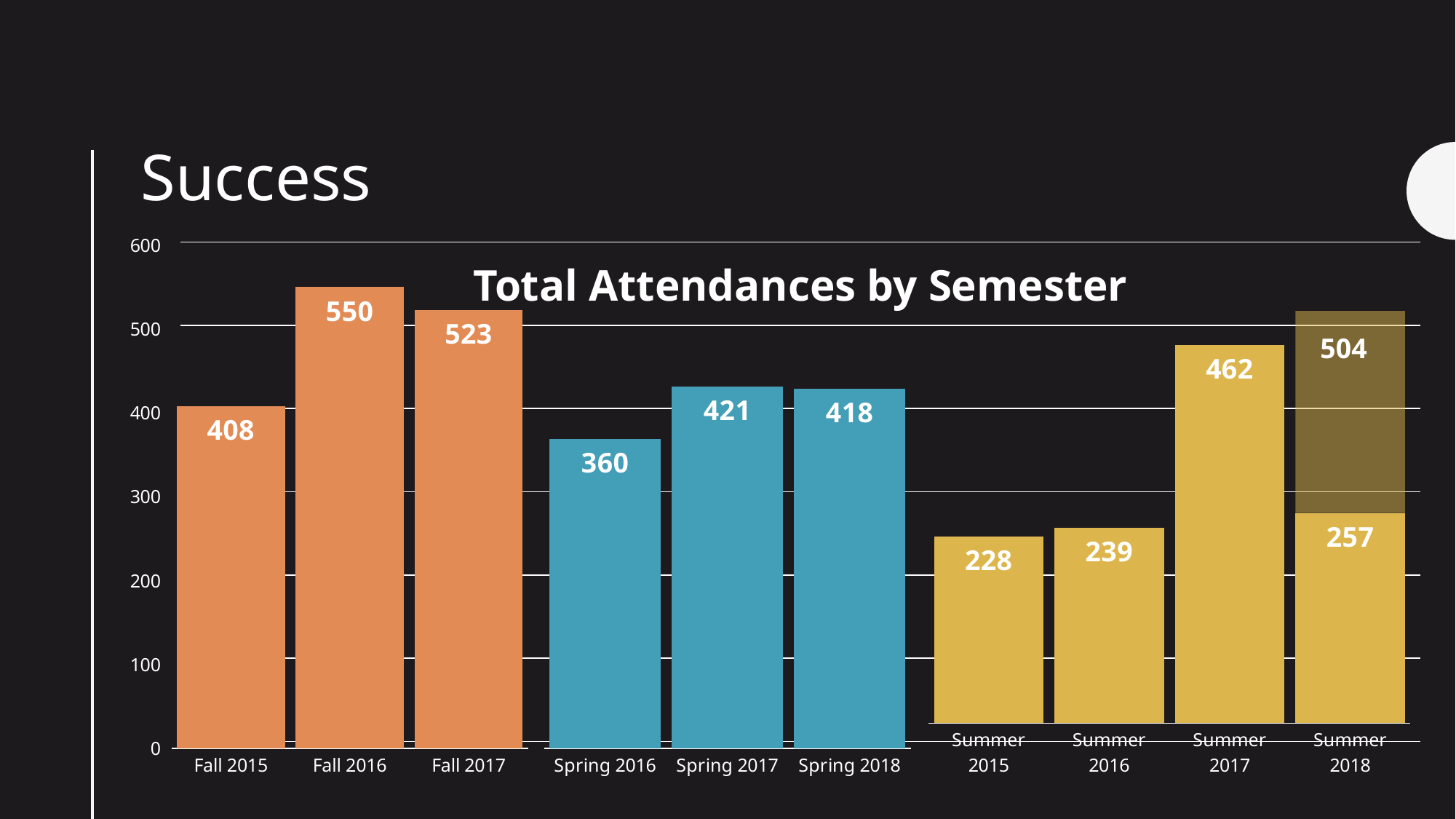
What is the value for Summer 2015? 228 What kind of chart is shown on the slide? bar chart Which semester has the lowest total attendance? Summer 2015 What is the difference between the values for Fall 2016 and Fall 2015? 142 Which is larger, the value for Spring 2017 or Spring 2018? Spring 2017 What is the difference between the values for Summer 2017 and Summer 2016? 223 What is the value for Spring 2016? 360 What is the value for Fall 2016 in the Total Attendances by Semester chart? 550 Which semester has the highest total attendance? Fall 2016 What is the title of the chart? Total Attendances by Semester Is the value for Fall 2017 greater or less than 500? greater How many semesters are shown on the x axis of the chart? 10